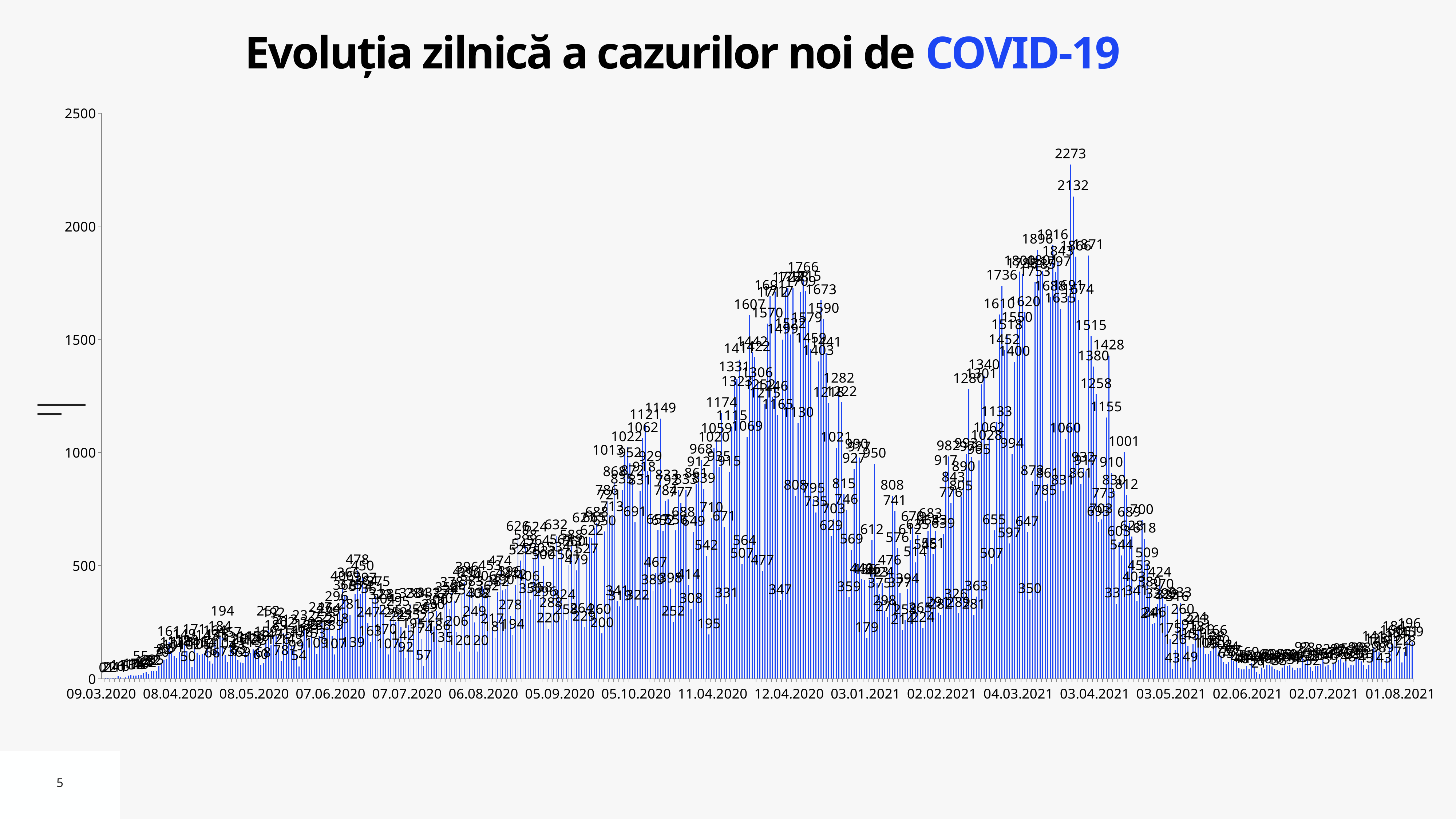
Do the values rise or fall between 03.04.2021 and 02.06.2021? fall Which peak is higher: the one near 12.04.2020 or the one near 03.04.2021? the one near 03.04.2021 What is the second-highest daily value labeled on the chart, next to the 2273 peak? 2132 How many date labels are shown on the x axis? 18 What colour are the bars in the chart? blue What is the highest daily value labeled on the chart? 2273 Is the value at the first date, 09.03.2020, greater or less than 500? less What is the title of the chart? Evoluția zilnică a cazurilor noi de COVID-19 Is the highest value on the chart greater or less than 2500? less What is the difference between the two highest labeled values, 2273 and 2132? 141 What kind of chart is shown on the slide? bar chart Is the highest value on the chart greater or less than 2000? greater